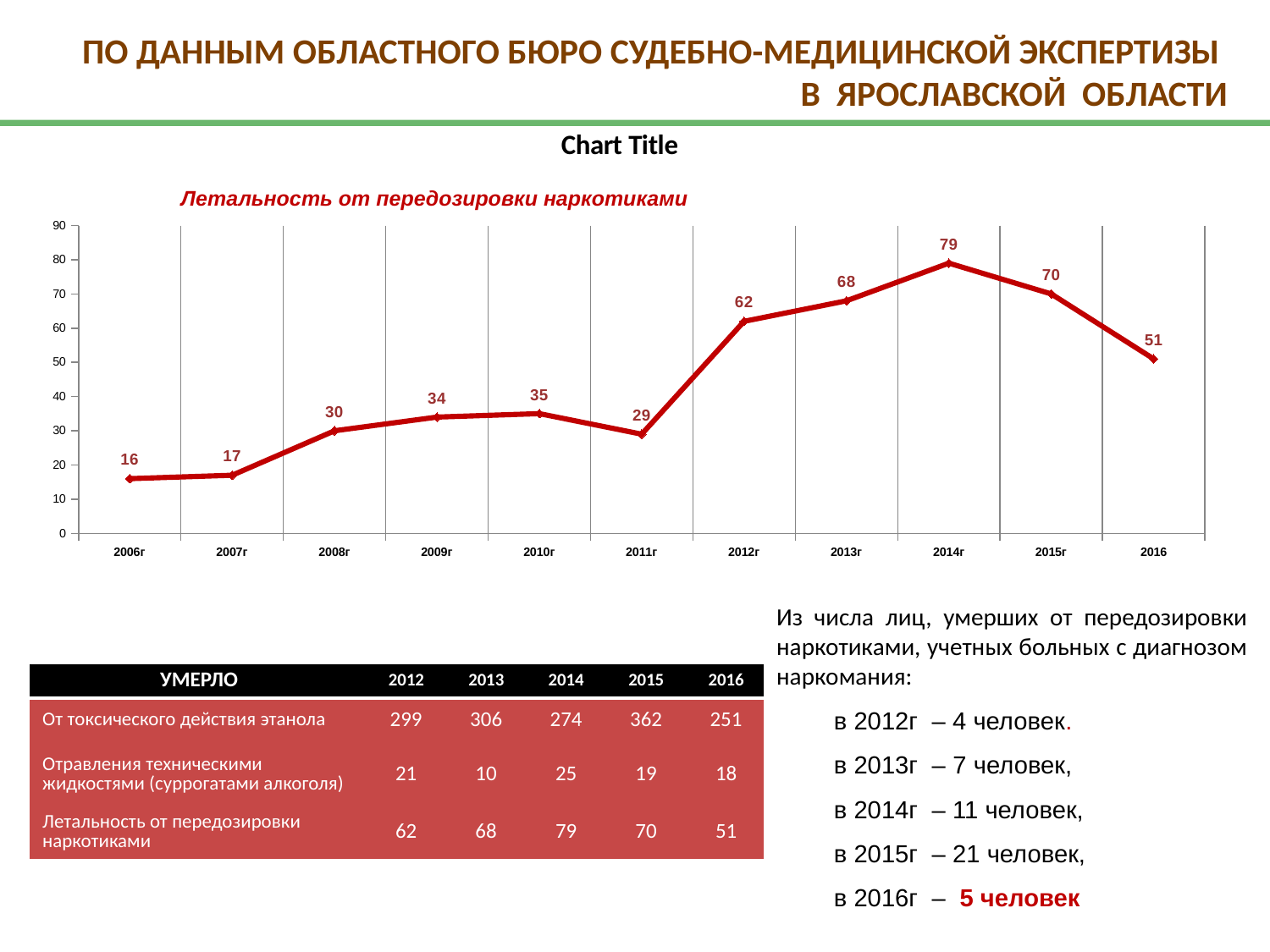
How many years are plotted on the line chart? 11 What is the value for 2011г on the line chart? 29 Is the value for 2015г on the line chart greater or less than 60? greater Which is larger on the line chart, the value for 2010г or the value for 2013г? 2013г What kind of chart is shown on the slide? line chart Which year has the highest value on the line chart? 2014г What is the value for 2014г on the line chart? 79 What is the difference between the values for 2012г and 2011г on the line chart? 33 What is the difference between the values for 2014г and 2016 on the line chart? 28 What is the value for 2006г on the line chart? 16 Does the line chart rise or fall from 2014г to 2016? fall Which year has the lowest value on the line chart? 2006г